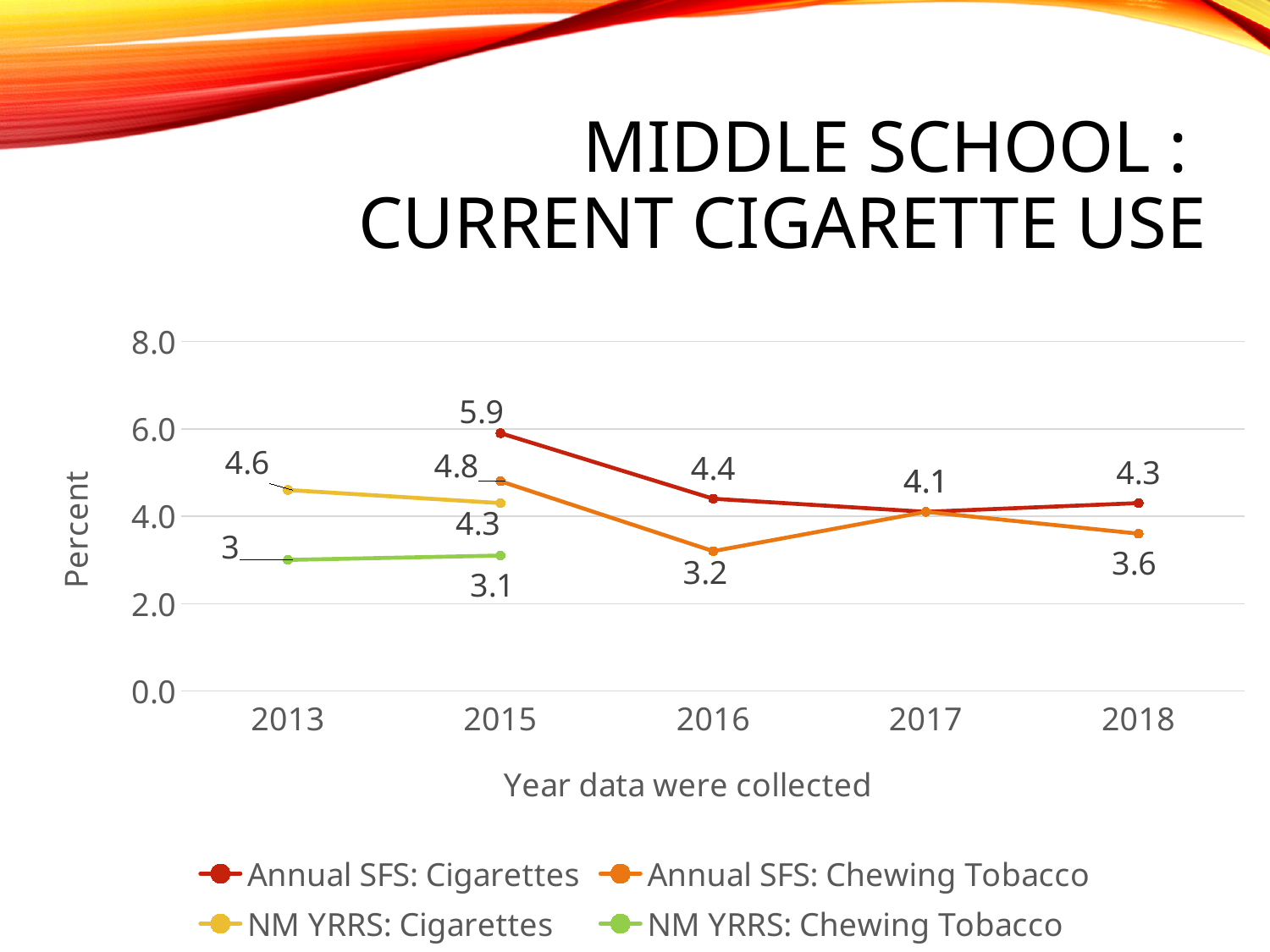
What is the value for Annual SFS: Chewing Tobacco in 2018? 3.6 What is the difference between Annual SFS: Cigarettes and Annual SFS: Chewing Tobacco in 2018? 0.7 How many series does the legend list? 4 In which year does Annual SFS: Cigarettes reach its highest value? 2015 What is the value for NM YRRS: Chewing Tobacco in 2015? 3.1 What type of chart is shown on the slide? Line chart Which is larger in 2016, Annual SFS: Cigarettes or Annual SFS: Chewing Tobacco? Annual SFS: Cigarettes What is the value for Annual SFS: Chewing Tobacco in 2016? 3.2 What is the label on the x axis? Year data were collected How many years are shown on the x axis? 5 What is the value for Annual SFS: Cigarettes in 2015? 5.9 What is the value for NM YRRS: Cigarettes in 2013? 4.6